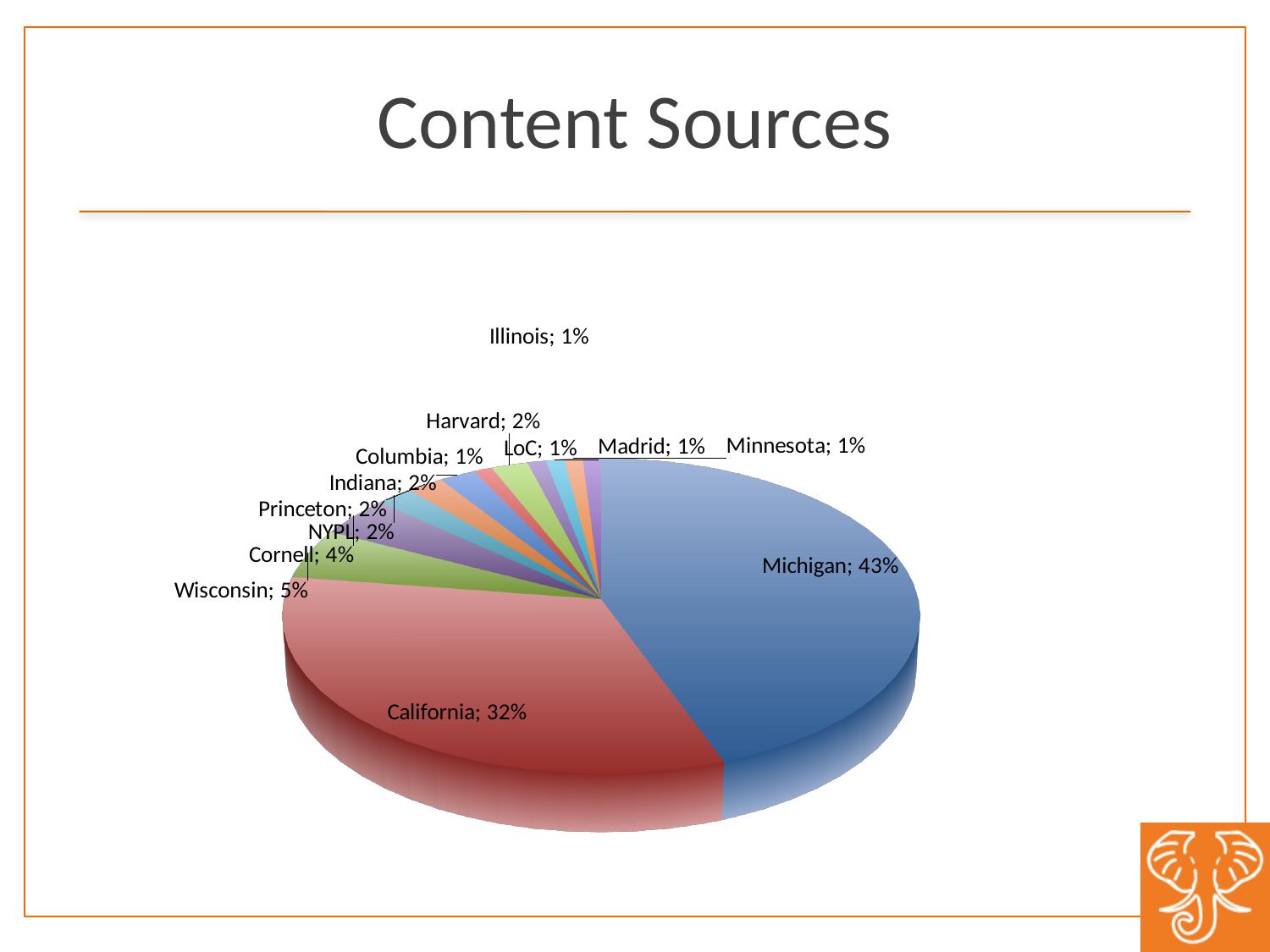
What is the value for Wisconsin? 5% What share of the pie does Michigan have? 43% What kind of chart is shown on the slide? Pie chart What share of the pie does California have? 32% What is the value for Harvard? 2% Which content source has the largest slice? Michigan What is the title of the chart? Content Sources Which is larger, the share for Wisconsin or the share for Cornell? Wisconsin What is the difference between the Michigan and California shares? 11% What is the value for Cornell? 4% How many content sources are shown in the pie chart? 13 What is the combined share of Michigan and California? 75%